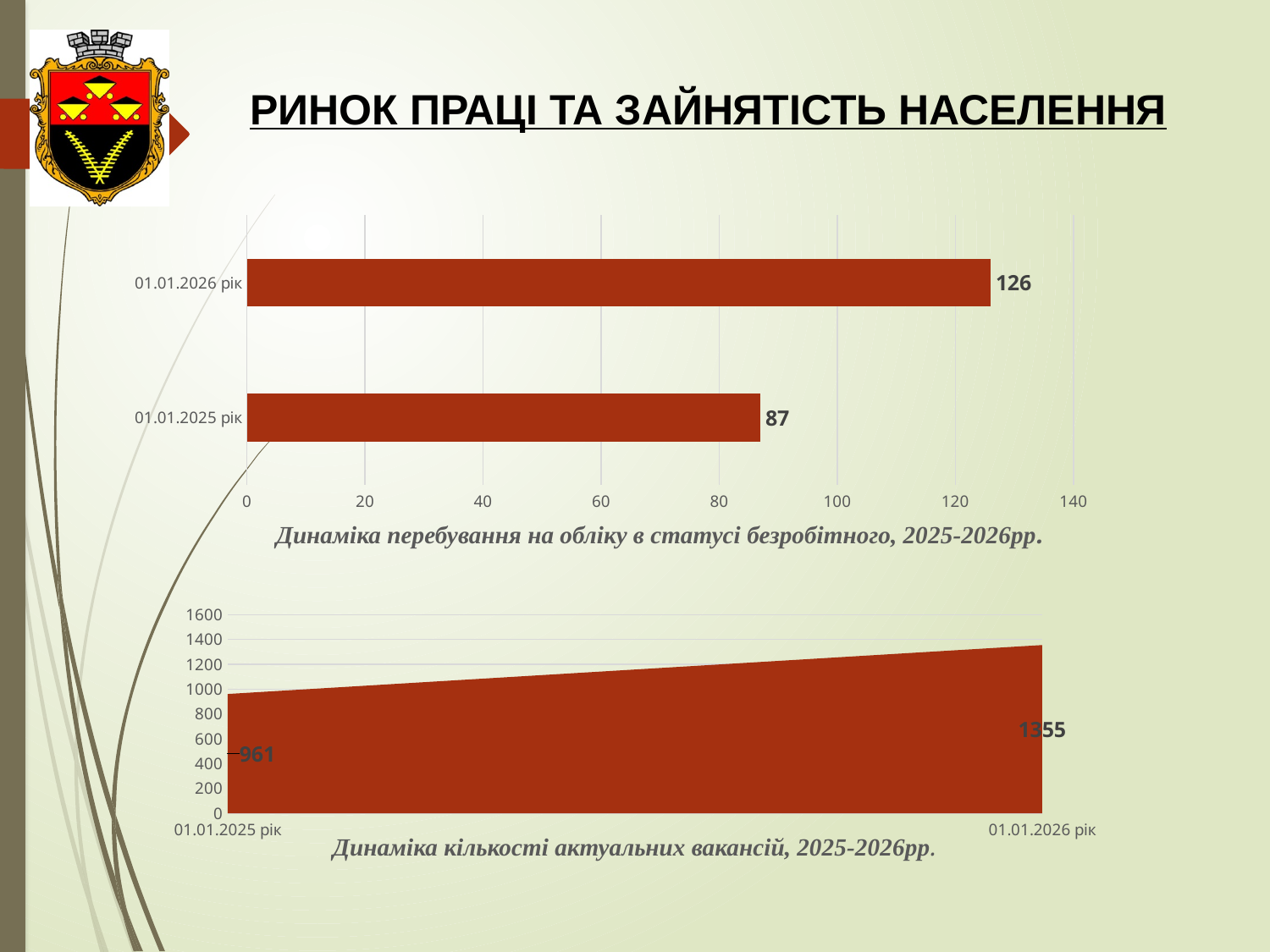
What is the title of the bottom chart? Динаміка кількості актуальних вакансій, 2025-2026рр. What kind of chart is the top chart on the slide? bar chart In the top chart (Динаміка перебування на обліку в статусі безробітного), what is the value for 01.01.2025 рік? 87 In the bottom chart, do the values rise or fall from 01.01.2025 рік to 01.01.2026 рік? rise In the top chart, is the value for 01.01.2025 рік greater or less than 100? less In the top chart, which category has the higher value? 01.01.2026 рік In the top chart (Динаміка перебування на обліку в статусі безробітного), what is the value for 01.01.2026 рік? 126 In the bottom chart (Динаміка кількості актуальних вакансій), what is the value for 01.01.2026 рік? 1355 In the bottom chart (Динаміка кількості актуальних вакансій), what is the value for 01.01.2025 рік? 961 How many categories are shown in the top chart? 2 In the top chart, what is the difference between the values for 01.01.2026 рік and 01.01.2025 рік? 39 In the bottom chart, which date has the lower value? 01.01.2025 рік